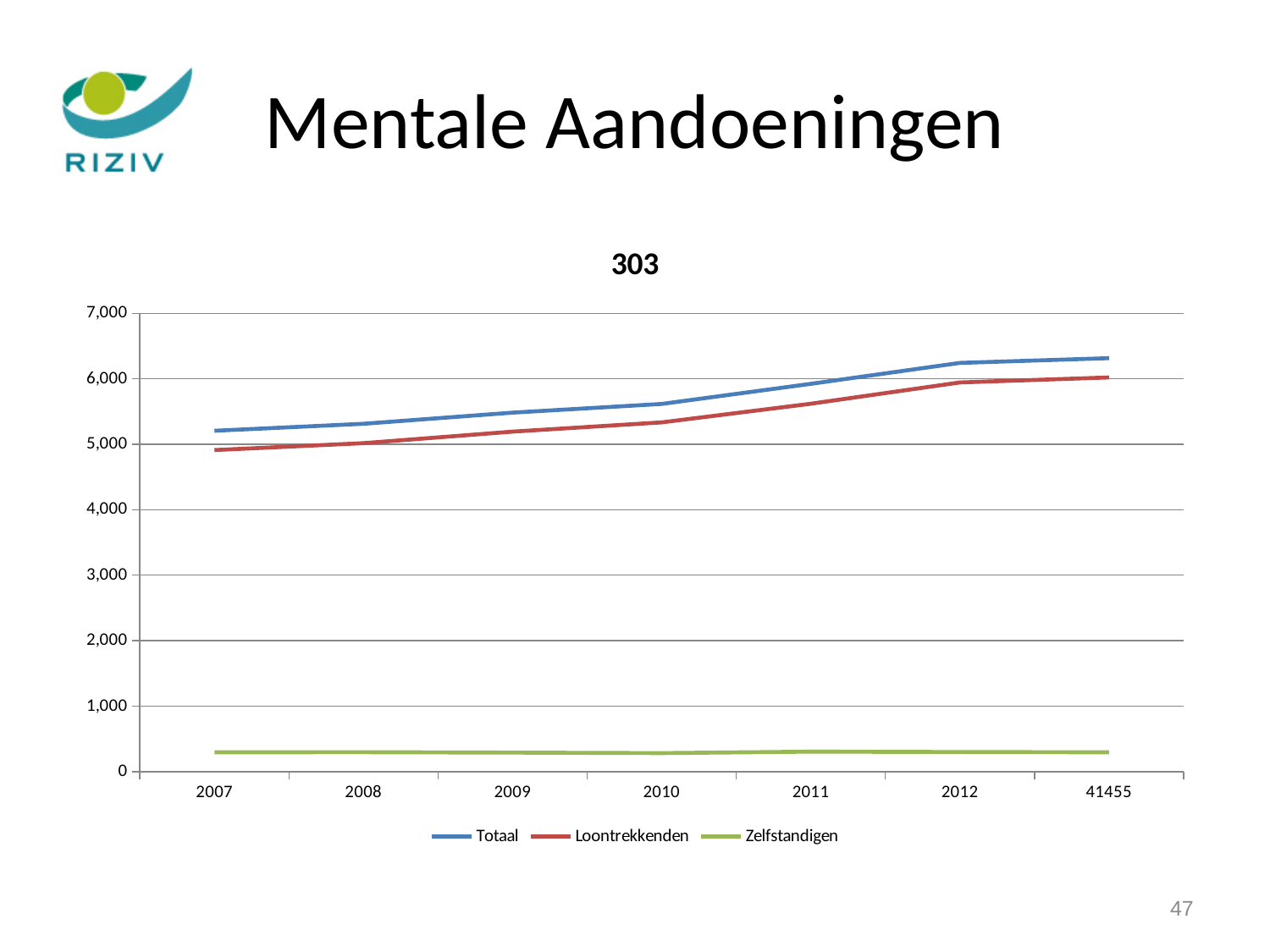
How many series does the legend list? 3 What kind of chart is shown on the slide? line chart Is the value for Totaal in 2012 greater or less than 6,000? greater How many points along the x axis does each line have? 7 Which series is drawn in green in the legend? Zelfstandigen In 2011, which is larger: Loontrekkenden or Zelfstandigen? Loontrekkenden Is the value for Zelfstandigen in 2009 greater or less than 1,000? less Which series has the lowest values across the chart? Zelfstandigen Does the Totaal line rise or fall from 2007 to the last point? rise Is the value for Loontrekkenden in 2010 greater or less than 5,000? greater Which series has the highest values across the chart? Totaal What is the title of the chart? 303